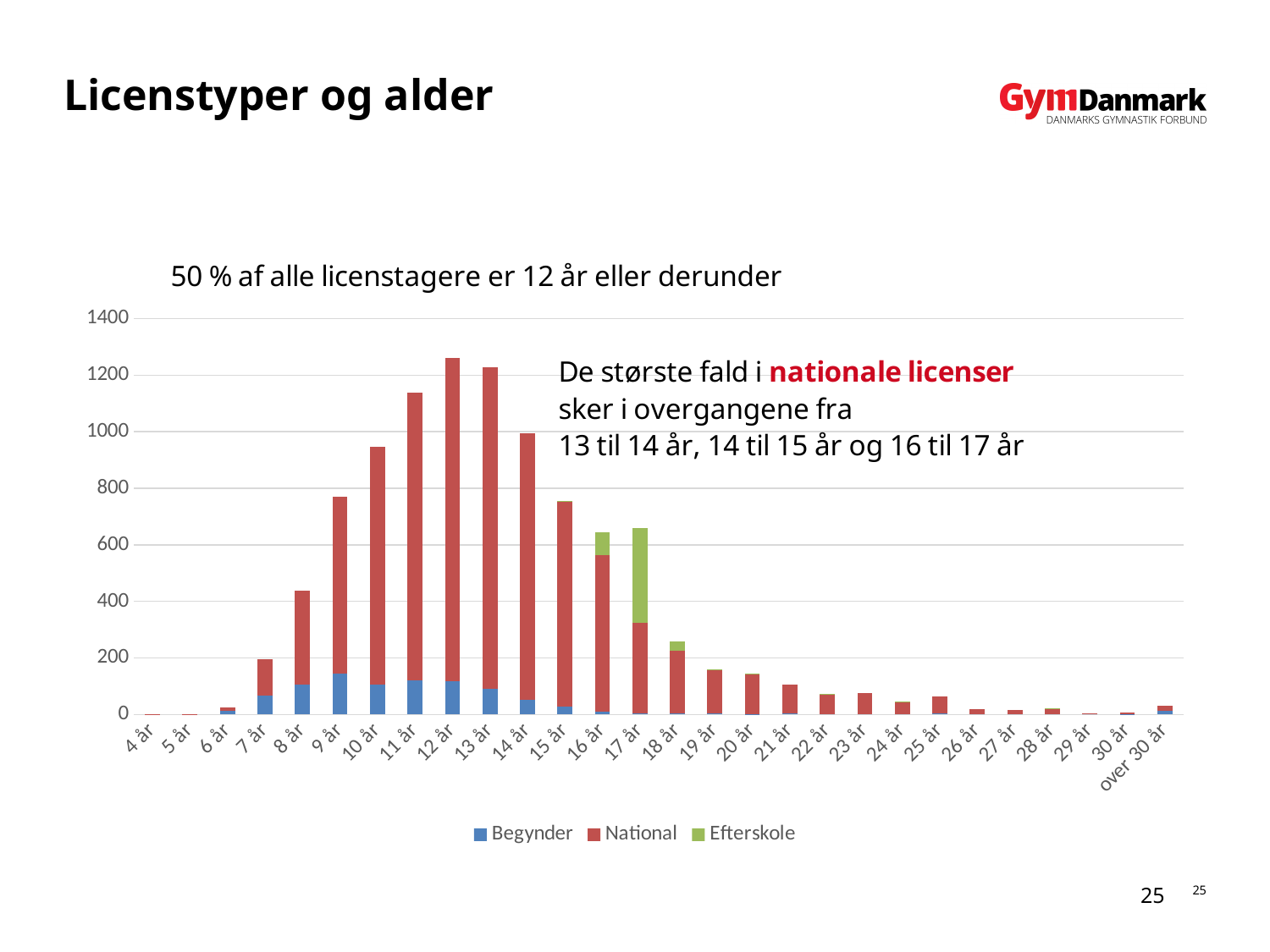
Which series are listed in the legend? Begynder, National, Efterskole Which age category has the tallest bar? 12 år Is the total value for 12 år greater or less than 1200? greater Is the total value for 9 år greater or less than 800? less What kind of chart is shown on the slide? Stacked bar chart Is the total value for 10 år greater or less than 1000? less Which age category has the largest Efterskole (green) segment? 17 år How many age categories are shown on the x axis? 28 How many series does the legend list? 3 Do the bar totals rise or fall from 12 år to 20 år? fall Which bar is taller, 11 år or 10 år? 11 år